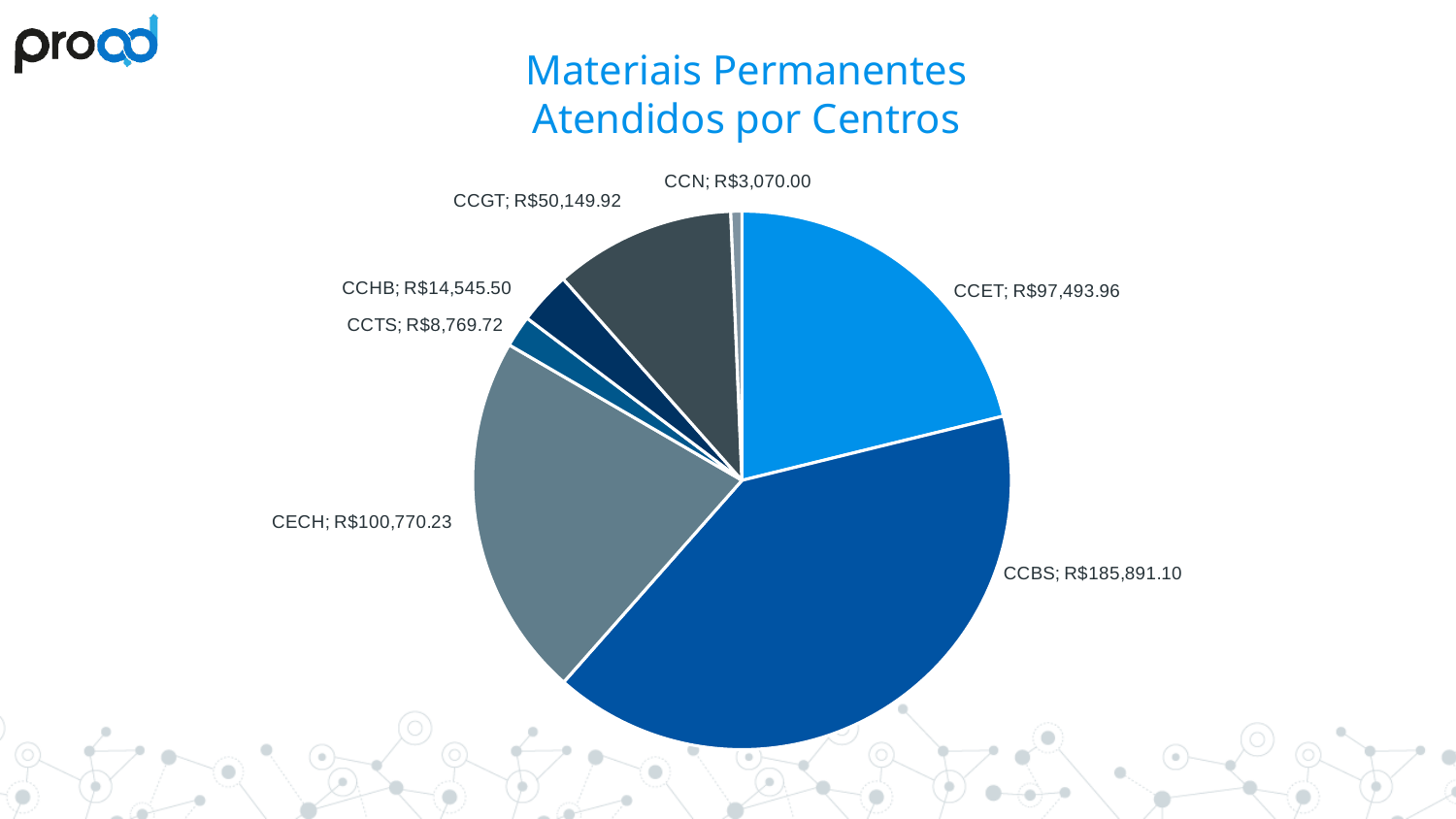
What is the value for CCGT? R$50,149.92 What kind of chart is shown on the slide? pie chart Which centre has the smallest slice? CCN What is the difference between the values for CCBS and CECH? R$85,120.87 Which is larger, the value for CCGT or the value for CCHB? CCGT How many slices does the pie chart have? 7 Which centre has the largest slice? CCBS What is the value for CCBS? R$185,891.10 What is the difference between the values for CCHB and CCTS? R$5,775.78 What is the value for CCTS? R$8,769.72 Which is larger, the value for CECH or the value for CCET? CECH What is the title of the chart? Materiais Permanentes Atendidos por Centros